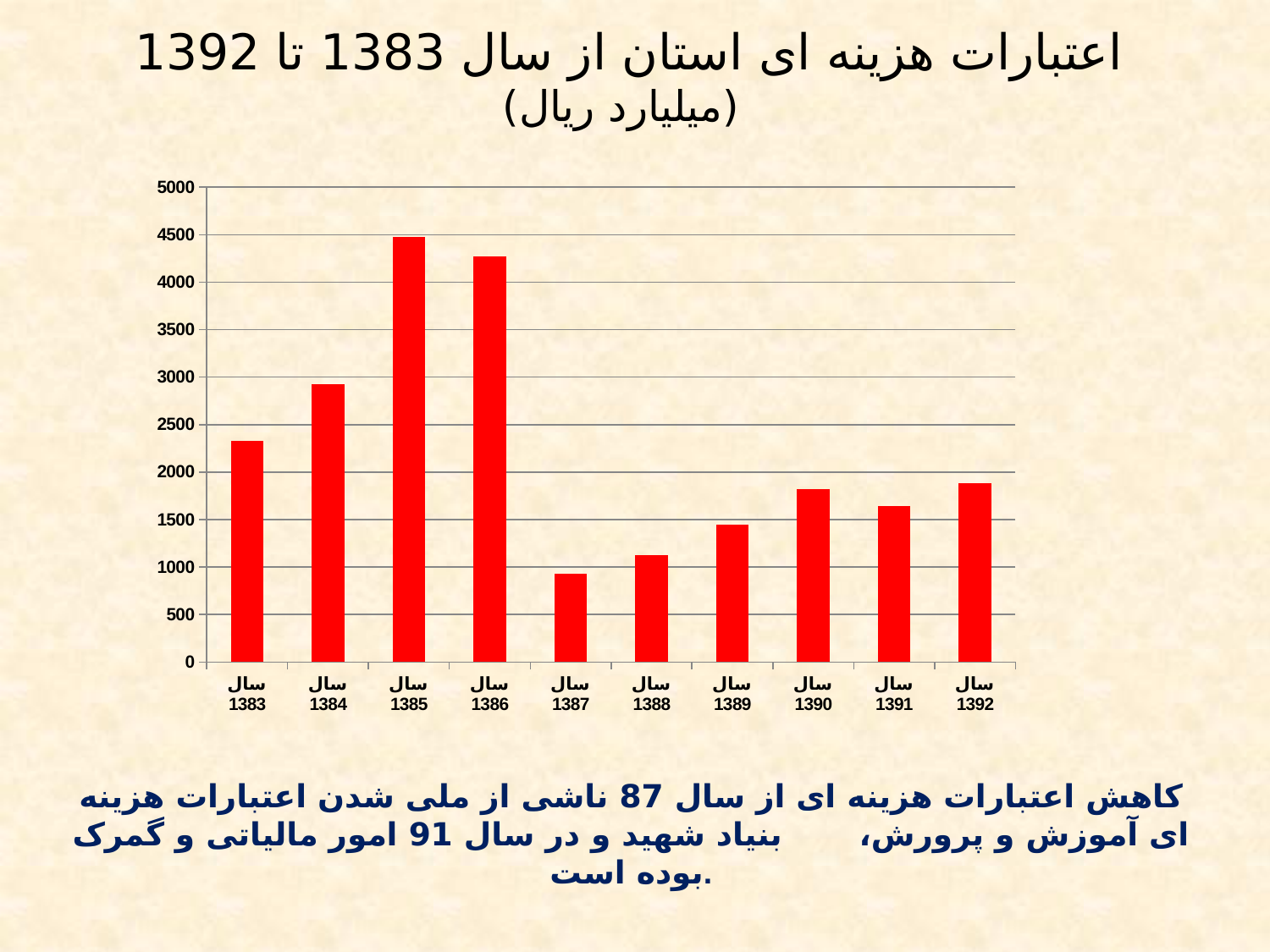
What kind of chart is shown on the slide? bar chart Is the value for سال 1384 greater or less than 2500? greater Which year has the lowest value in the chart? سال 1387 Which is larger, the value for سال 1385 or the value for سال 1386? سال 1385 Is the value for سال 1385 greater or less than 4000? greater Which year has the highest value in the chart? سال 1385 Do the values rise or fall from سال 1387 to سال 1390? rise Is the value for سال 1387 greater or less than 1000? less Which is larger, the value for سال 1384 or the value for سال 1383? سال 1384 How many years (bars) are plotted in the chart? 10 What is the unit given in the chart title (in parentheses)? میلیارد ریال